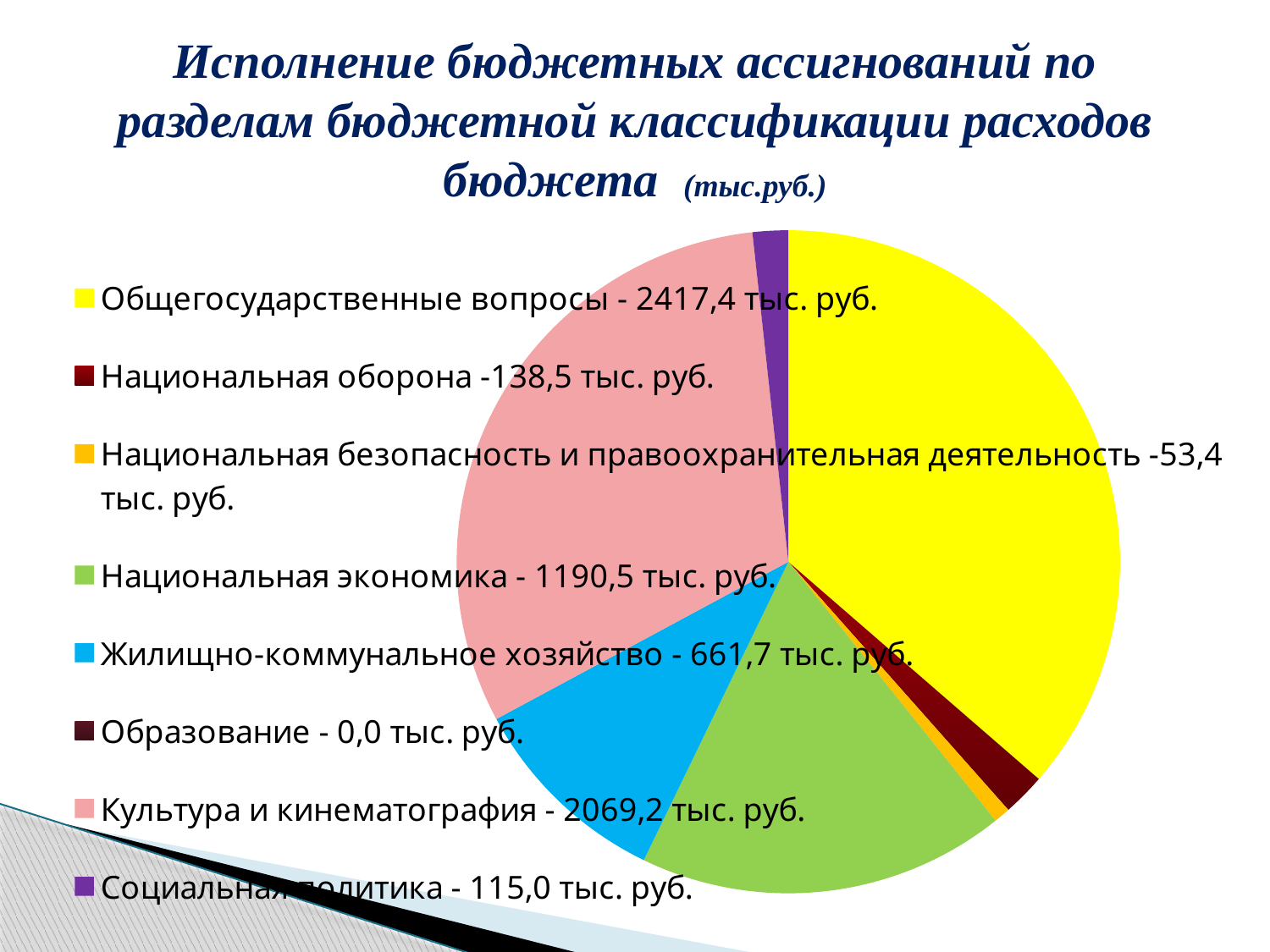
What is the difference between Общегосударственные вопросы and Культура и кинематография? 348,2 тыс. руб. What colour is the slice for Жилищно-коммунальное хозяйство? Blue What is the difference between Национальная оборона and Социальная политика? 23,5 тыс. руб. Which is larger: Национальная экономика or Жилищно-коммунальное хозяйство? Национальная экономика What is the value for Образование? 0,0 тыс. руб. Which category has the largest value in the pie chart? Общегосударственные вопросы How many categories does the legend of the pie chart list? 8 What kind of chart is shown on the slide? Pie chart What is the value for Культура и кинематография? 2069,2 тыс. руб. Which category has the smallest value in the pie chart? Образование What is the value for Общегосударственные вопросы? 2417,4 тыс. руб. What is the value for Национальная безопасность и правоохранительная деятельность? 53,4 тыс. руб.